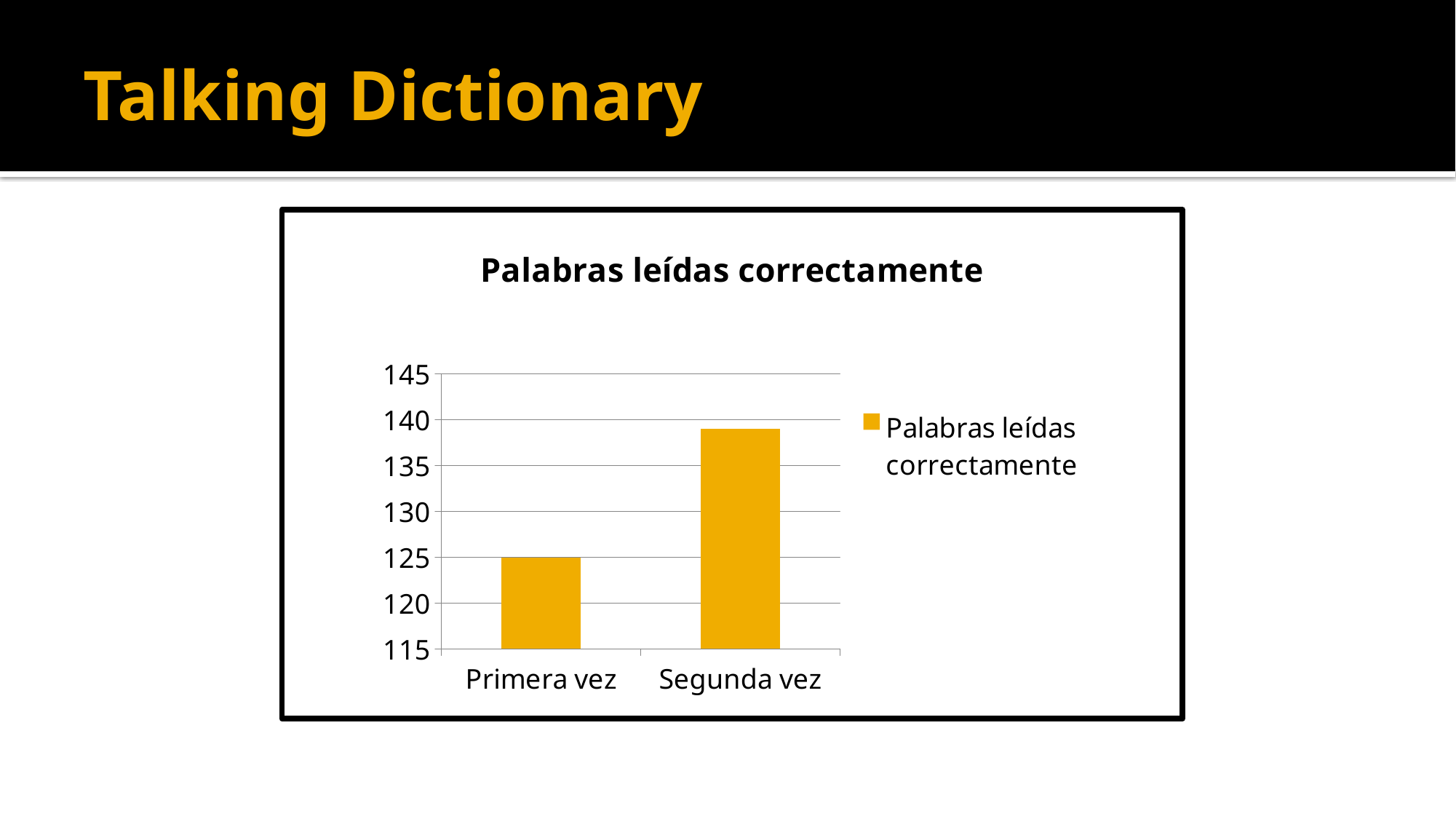
Is the value for Segunda vez greater or less than 135? greater Is the value for Segunda vez greater or less than 140? less Which category has the highest value? Segunda vez Which category has the lowest value? Primera vez What kind of chart is shown on the slide? bar chart Which is larger, the value for Primera vez or the value for Segunda vez? Segunda vez How many series does the chart legend list? 1 Do the values rise or fall from Primera vez to Segunda vez? rise What is the value for Primera vez? 125 How many categories are shown on the x axis of the chart? 2 What is the name of the series shown in the legend? Palabras leídas correctamente What is the title of the chart? Palabras leídas correctamente